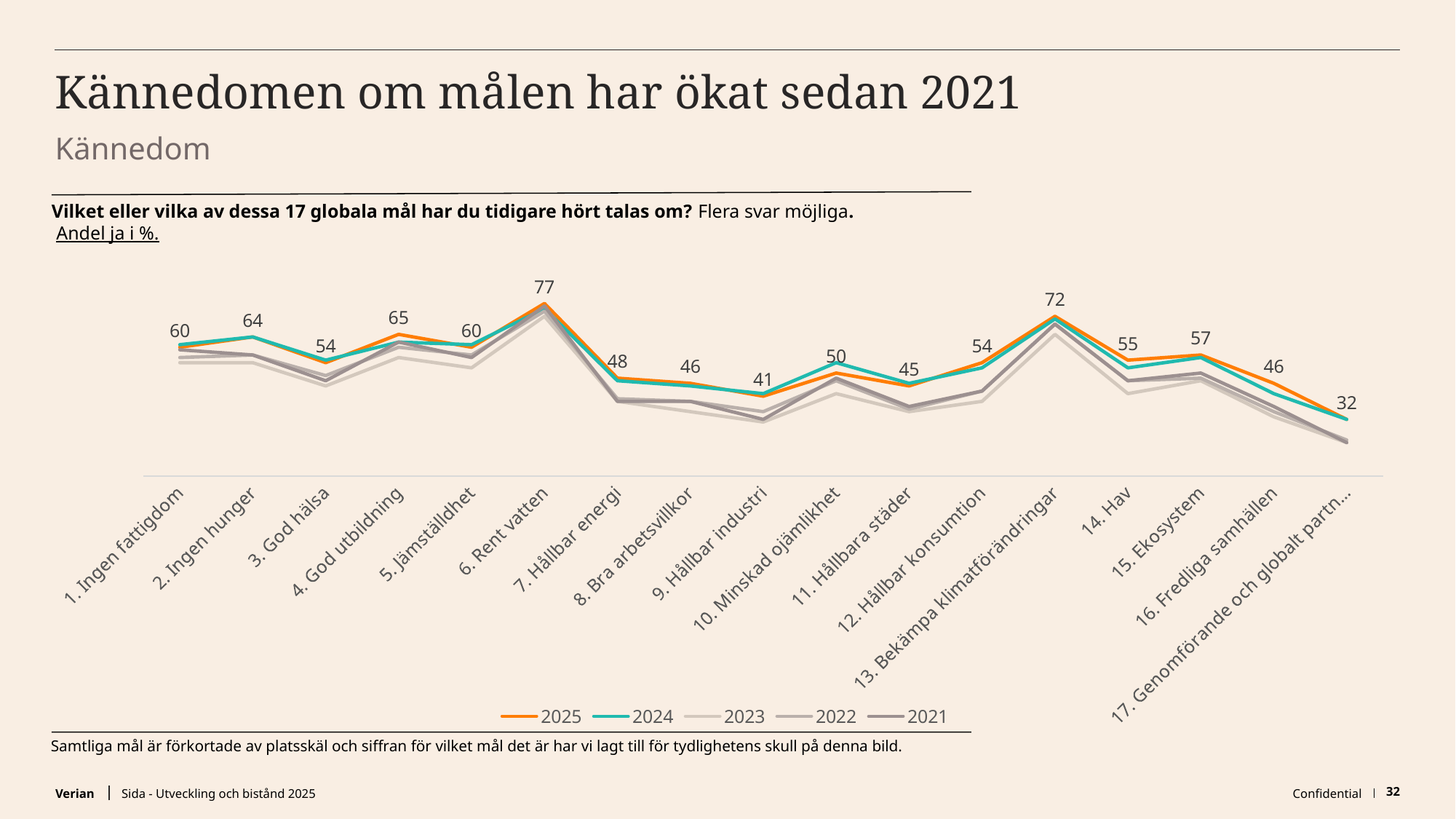
Which goal has the highest labelled value? 6. Rent vatten What value is labelled for '9. Hållbar industri'? 41 How many goals (categories) are plotted along the x axis? 17 Which has a higher labelled value, '2. Ingen hunger' or '3. God hälsa'? 2. Ingen hunger Which years are listed in the chart legend? 2025, 2024, 2023, 2022, 2021 How many series does the legend list? 5 What value is labelled for '13. Bekämpa klimatförändringar'? 72 Do the labelled values rise or fall from '6. Rent vatten' to '9. Hållbar industri'? fall What is the difference between the labelled values for '6. Rent vatten' and '17. Genomförande och globalt partn...'? 45 What kind of chart is shown on the slide? line chart What value is labelled for '6. Rent vatten'? 77 Which goal has the lowest labelled value? 17. Genomförande och globalt partn...